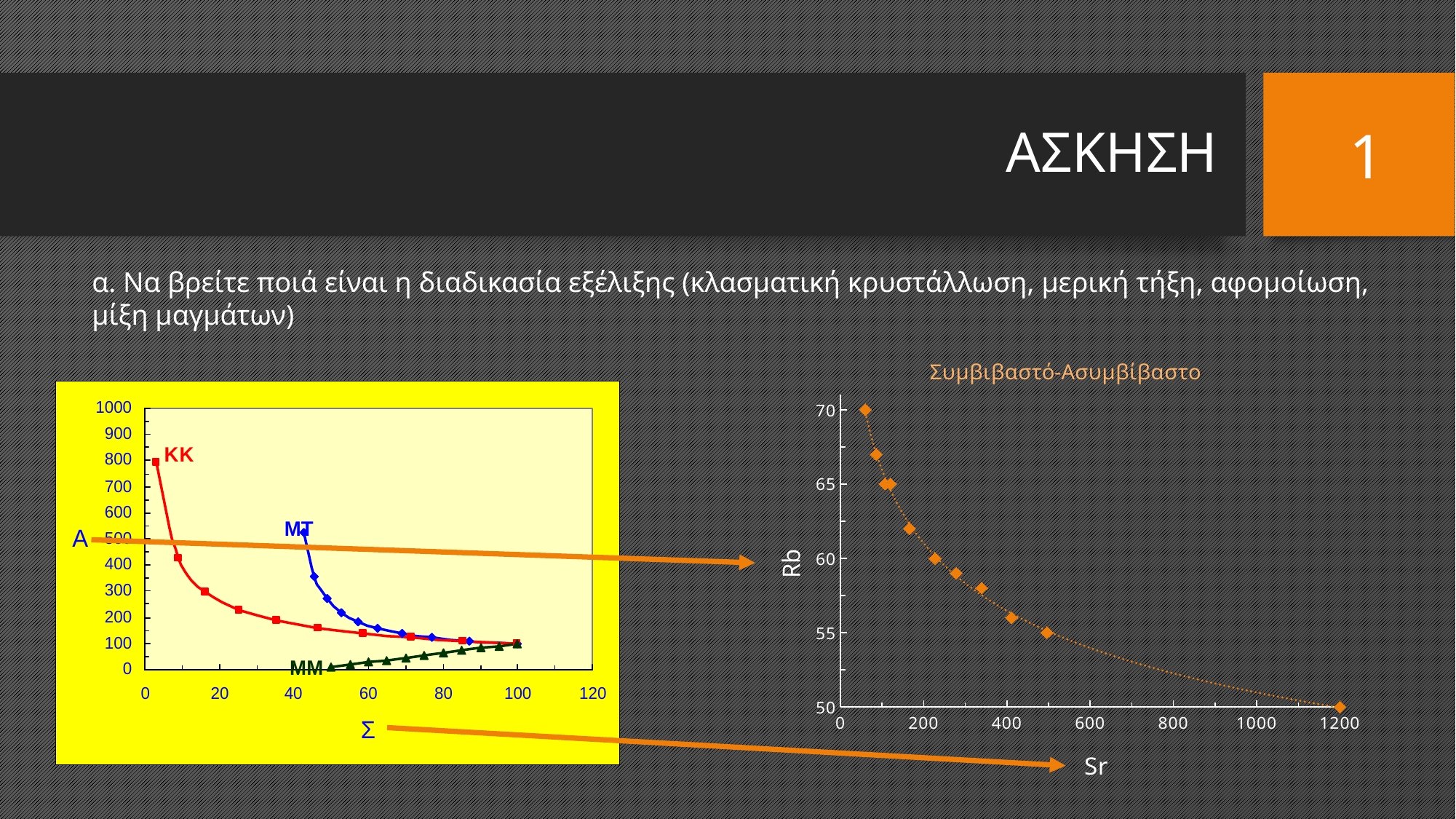
What is the title of the right-hand chart? Συμβιβαστό-Ασυμβίβαστο How many series are plotted in the left-hand chart (A vs Σ)? 3 In the left-hand chart (A vs Σ), which series starts at the highest A value? KK What kind of chart is the right-hand chart titled Συμβιβαστό-Ασυμβίβαστο? scatter chart In the left-hand chart (A vs Σ), which series has the lowest A values? MM In the left-hand chart (A vs Σ), is the highest A value of the MT series greater or less than 600? less In the right-hand chart (Rb vs Sr), what is the Rb value of the point with the highest Sr? 50 In the right-hand chart (Rb vs Sr), what is the Sr value of the rightmost point? 1200 In the left-hand chart (A vs Σ), what colour is the MT series? blue In the right-hand chart (Rb vs Sr), do the Rb values rise or fall as Sr increases? fall In the right-hand chart (Rb vs Sr), what is the highest Rb value plotted? 70 In the right-hand chart (Rb vs Sr), is the Rb value of the point at Sr of about 500 greater or less than 60? less